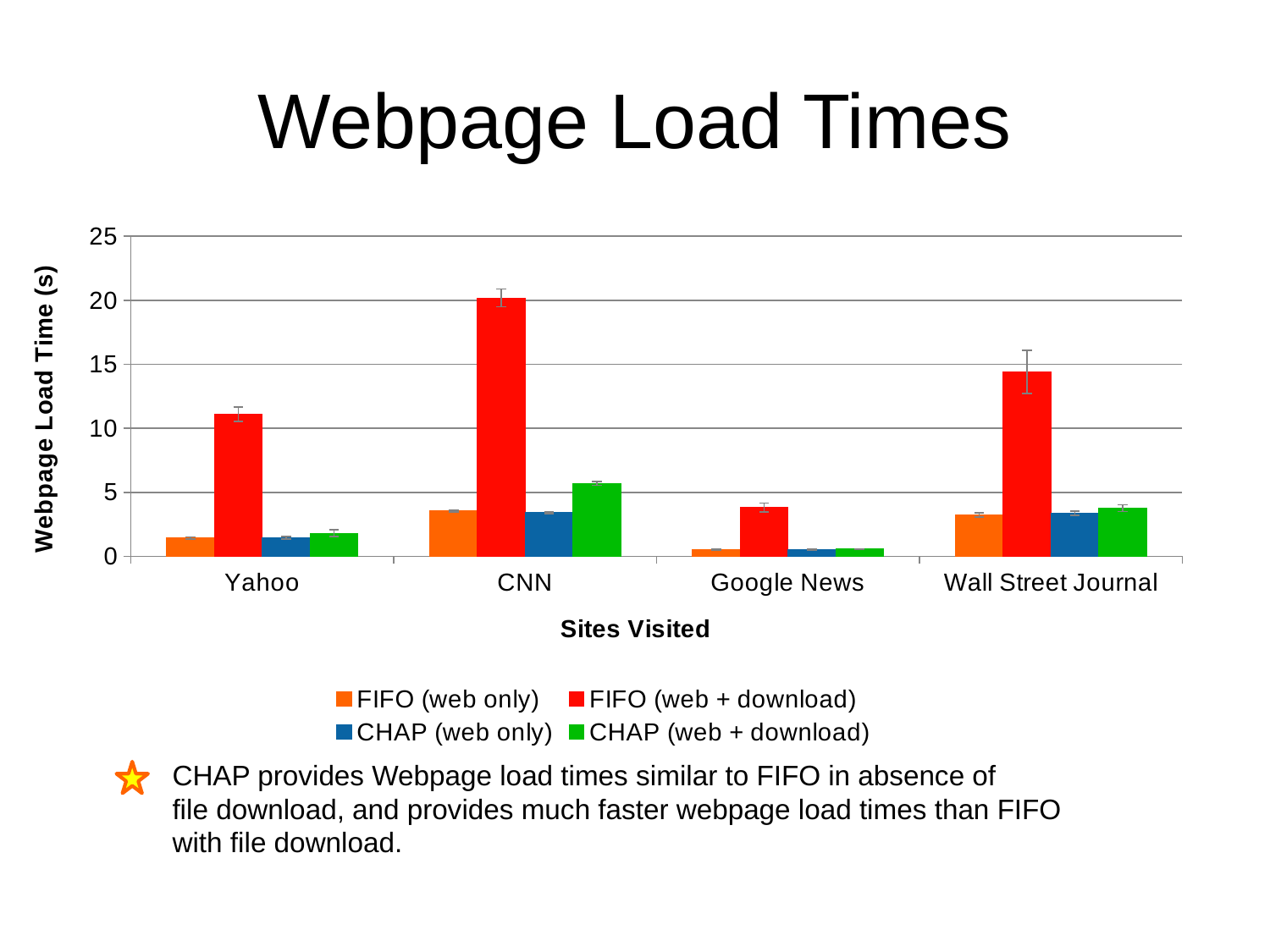
Is the FIFO (web + download) value for CNN greater or less than 15? greater How many sites are shown on the x axis of the chart? 4 Is the FIFO (web + download) value for Google News greater or less than 5? less Which series has the highest value for Wall Street Journal? FIFO (web + download) What is the title of the y axis? Webpage Load Time (s) Which site has the highest FIFO (web + download) load time? CNN Which site has the lowest FIFO (web + download) load time? Google News Is the CHAP (web + download) value for CNN greater or less than 5? greater Which is larger: the FIFO (web + download) value for Wall Street Journal or for Yahoo? Wall Street Journal What kind of chart is shown on the slide? Bar chart How many series does the legend list? 4